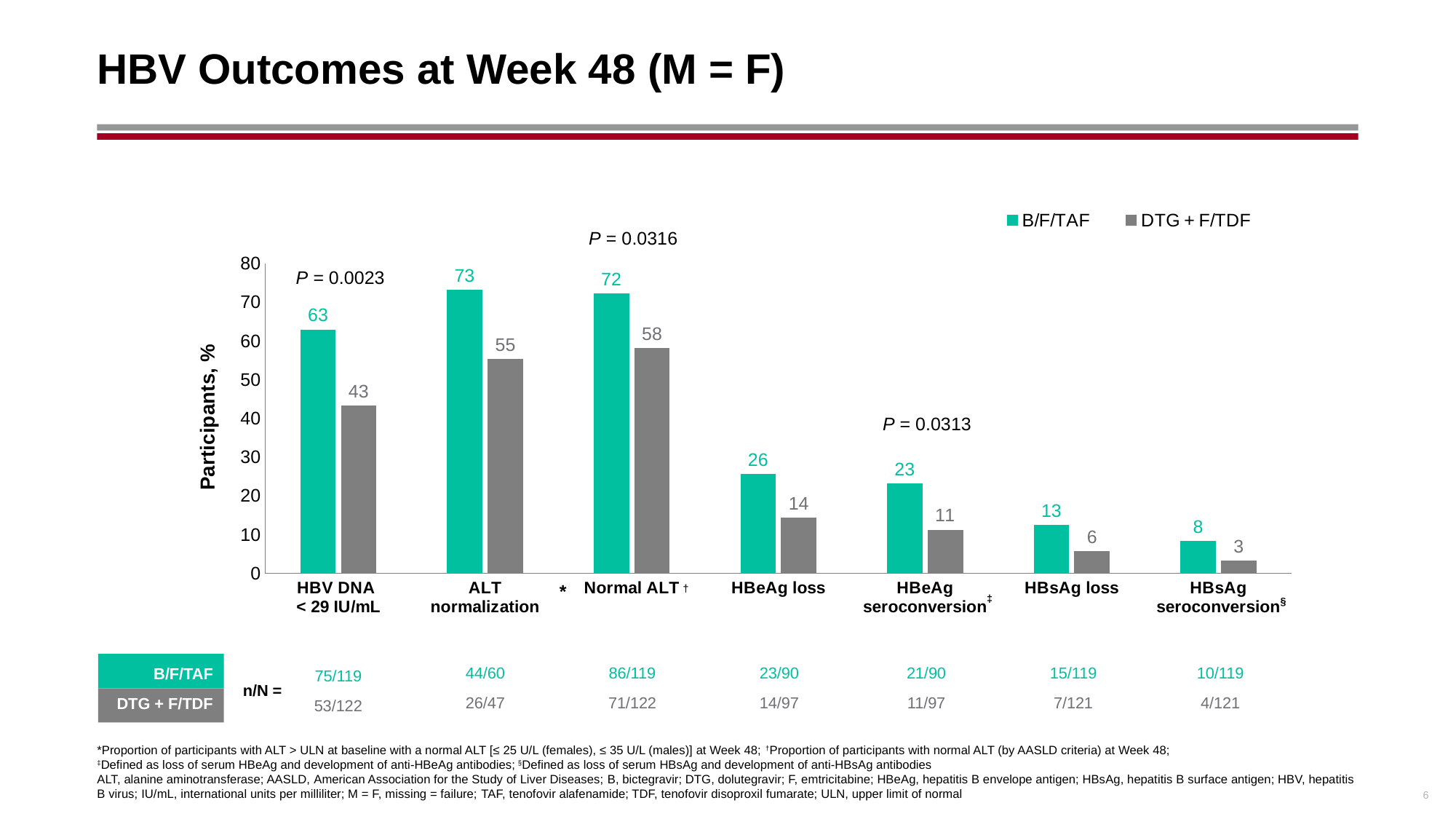
How many series does the legend list? 2 What is the difference between the B/F/TAF and DTG + F/TDF values in the HBeAg loss category? 12 What is the value for DTG + F/TDF in the HBsAg seroconversion category? 3 Which category has the highest value for B/F/TAF? ALT normalization What is the difference between the B/F/TAF and DTG + F/TDF values in the HBV DNA < 29 IU/mL category? 20 What is the value for DTG + F/TDF in the ALT normalization category? 55 What is the value for B/F/TAF in the HBV DNA < 29 IU/mL category? 63 Which is larger in the Normal ALT category: B/F/TAF or DTG + F/TDF? B/F/TAF What is the label of the y axis? Participants, % How many categories are shown on the x axis? 7 What kind of chart is shown on the slide? Bar chart Which category has the lowest value for DTG + F/TDF? HBsAg seroconversion